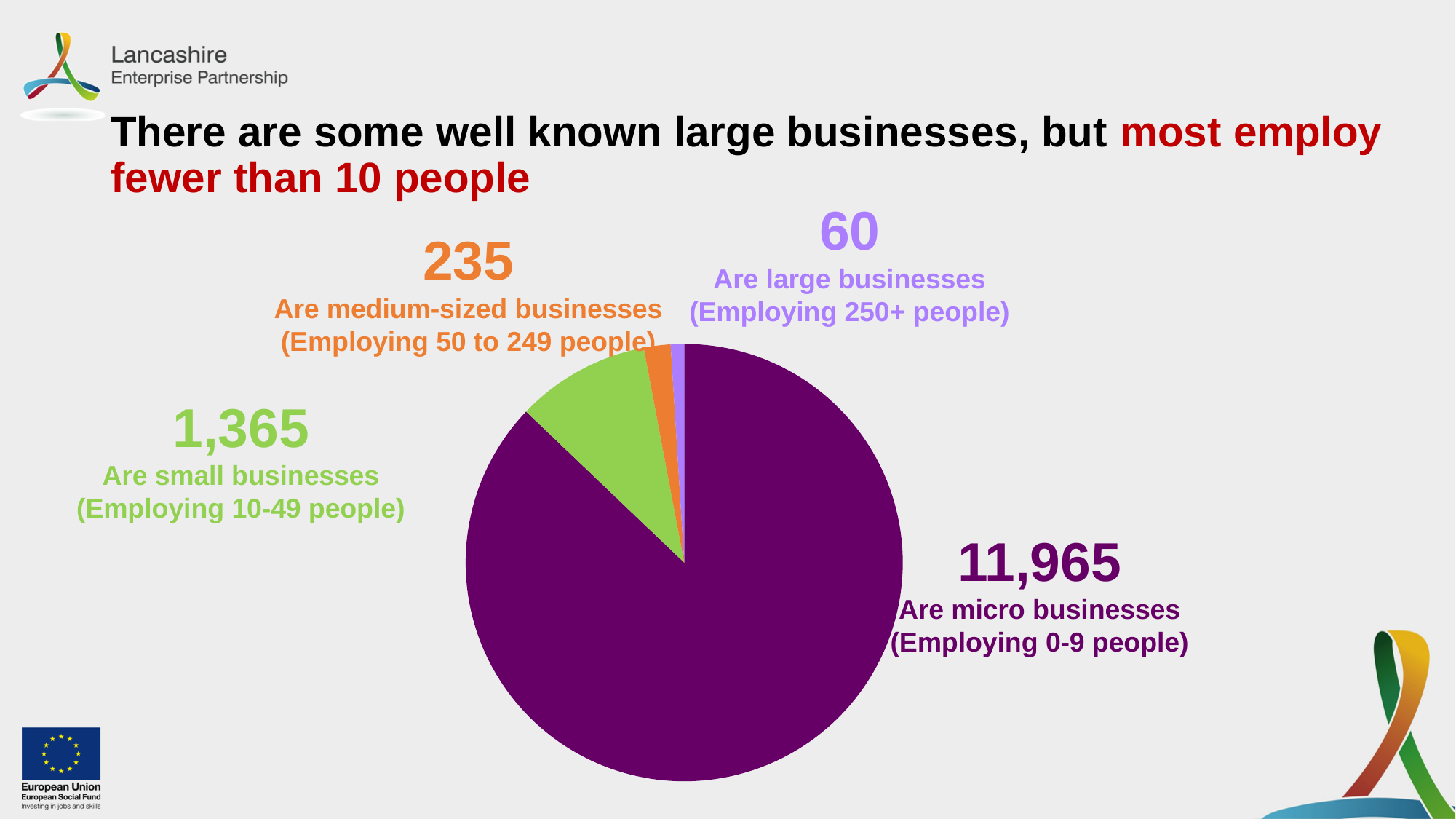
What kind of chart is shown on the slide? Pie chart How many large businesses (employing 250+ people) are there? 60 How many small businesses (employing 10-49 people) are there? 1,365 Which is larger: the number of medium-sized businesses or the number of large businesses? Medium-sized businesses How many slices does the pie chart have? 4 What is the total number of businesses represented in the pie chart? 13,625 Which business size category has the smallest slice of the pie? Large businesses (Employing 250+ people) Which business size category has the largest slice of the pie? Micro businesses (Employing 0-9 people) What is the difference between the number of micro businesses and the number of small businesses? 10,600 What colour is the slice representing micro businesses? Purple How many medium-sized businesses (employing 50 to 249 people) are there? 235 How many micro businesses (employing 0-9 people) are there? 11,965